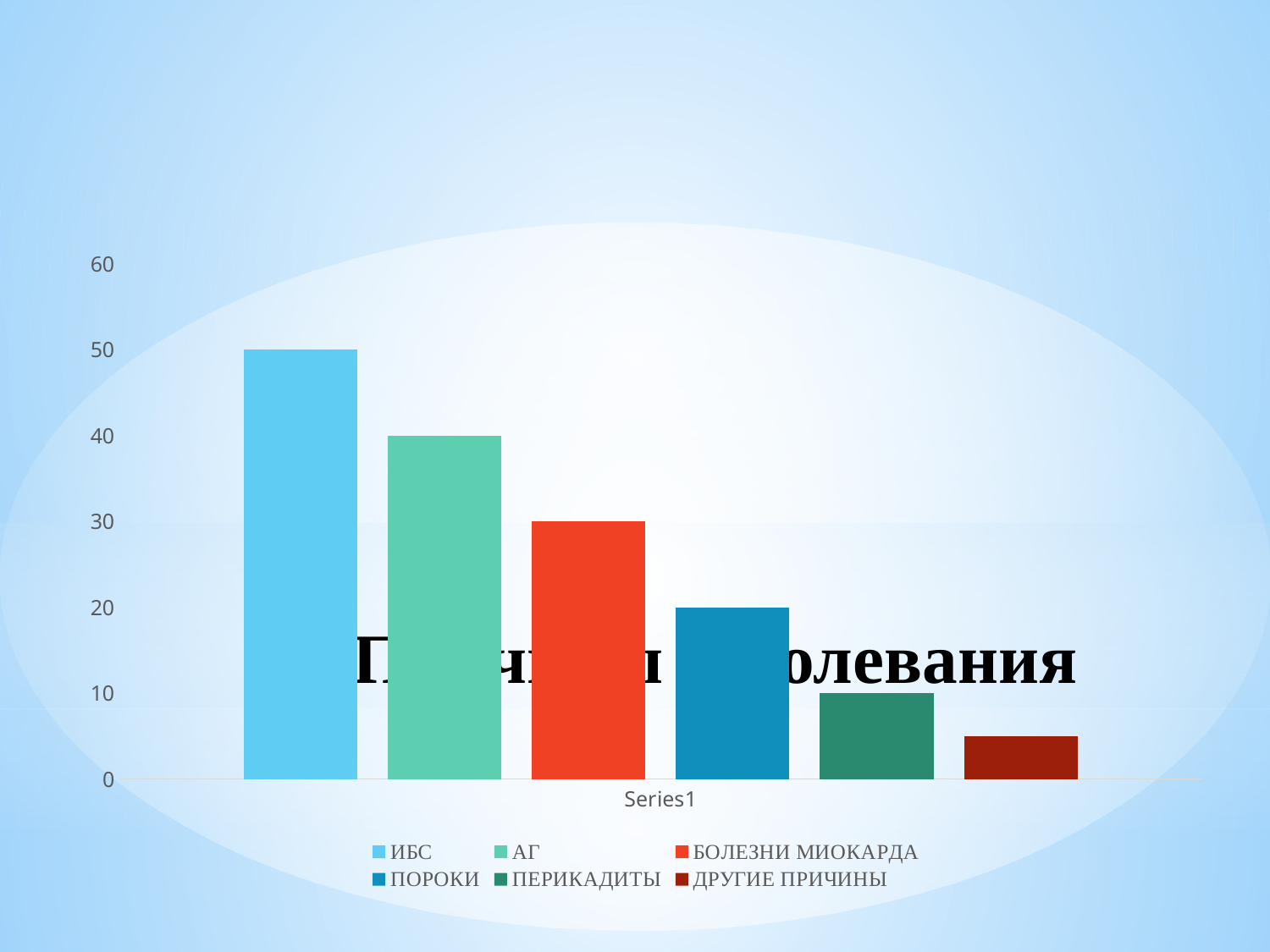
What is the difference between the values for ИБС and АГ? 10 What is the value for ИБС? 50 Do the bar values rise or fall from left to right? fall Which series has the lowest value? ДРУГИЕ ПРИЧИНЫ Is the value for ДРУГИЕ ПРИЧИНЫ greater or less than 10? less Which series has the highest value? ИБС How many series does the legend list? 6 What is the value for ПЕРИКАДИТЫ? 10 What is the value for АГ? 40 What is the value for ПОРОКИ? 20 What is the value for БОЛЕЗНИ МИОКАРДА? 30 What kind of chart is shown on the slide? bar chart